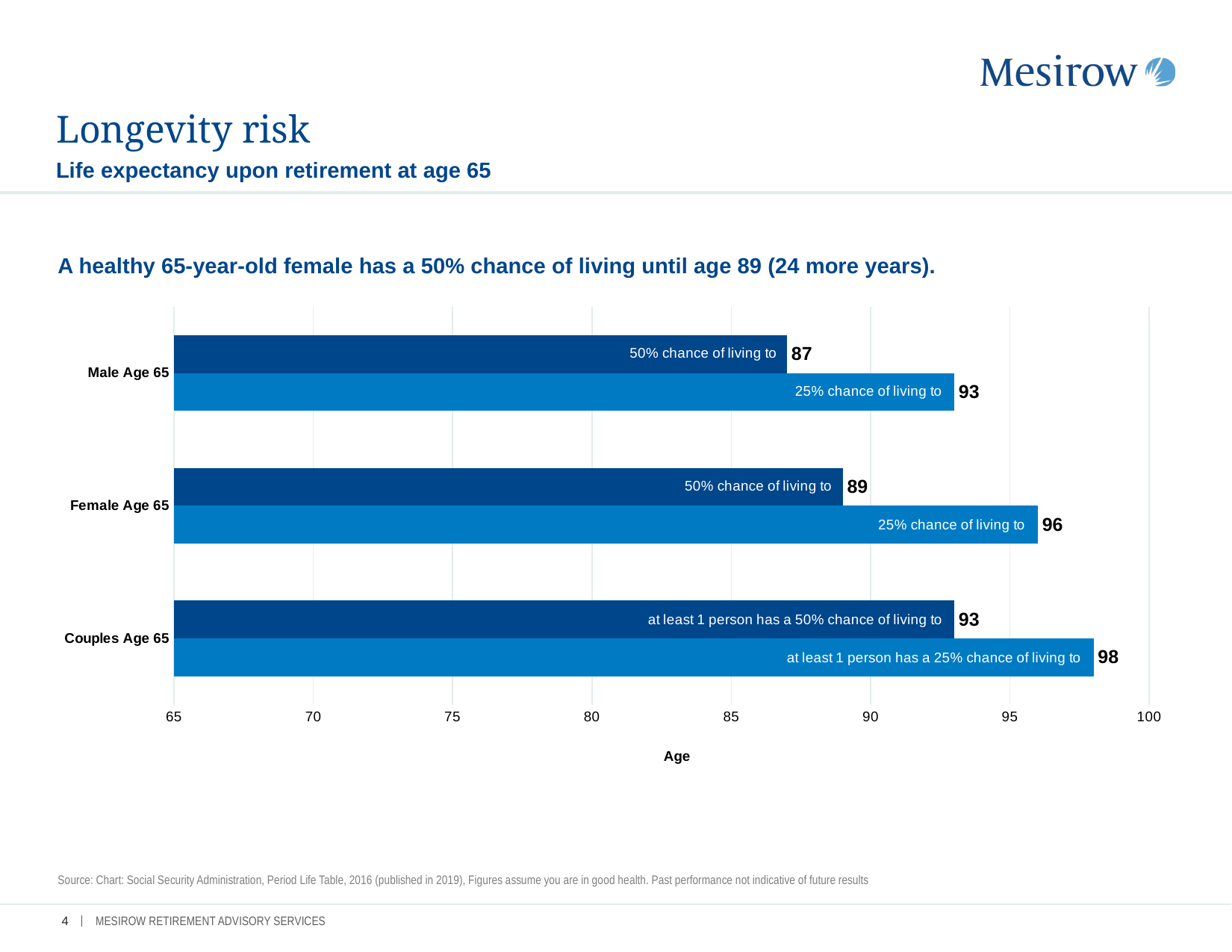
For couples age 65, what age does at least 1 person have a 50% chance of living to? 93 For couples age 65, what age does at least 1 person have a 25% chance of living to? 98 Which is larger: the 25% chance age for Male Age 65 or the 50% chance age for Female Age 65? 25% chance age for Male Age 65 What is the difference between the 50% chance of living to ages for Female Age 65 and Male Age 65? 2 What is the difference between the 25% chance and 50% chance ages for Female Age 65? 7 What age does a 65-year-old male have a 50% chance of living to? 87 What age does a 65-year-old female have a 25% chance of living to? 96 How many categories are shown on the chart? 3 What kind of chart is shown on the slide? Bar chart Which category has the lowest 50% chance of living to age? Male Age 65 What is the label of the horizontal axis? Age Which category has the highest 25% chance of living to age? Couples Age 65